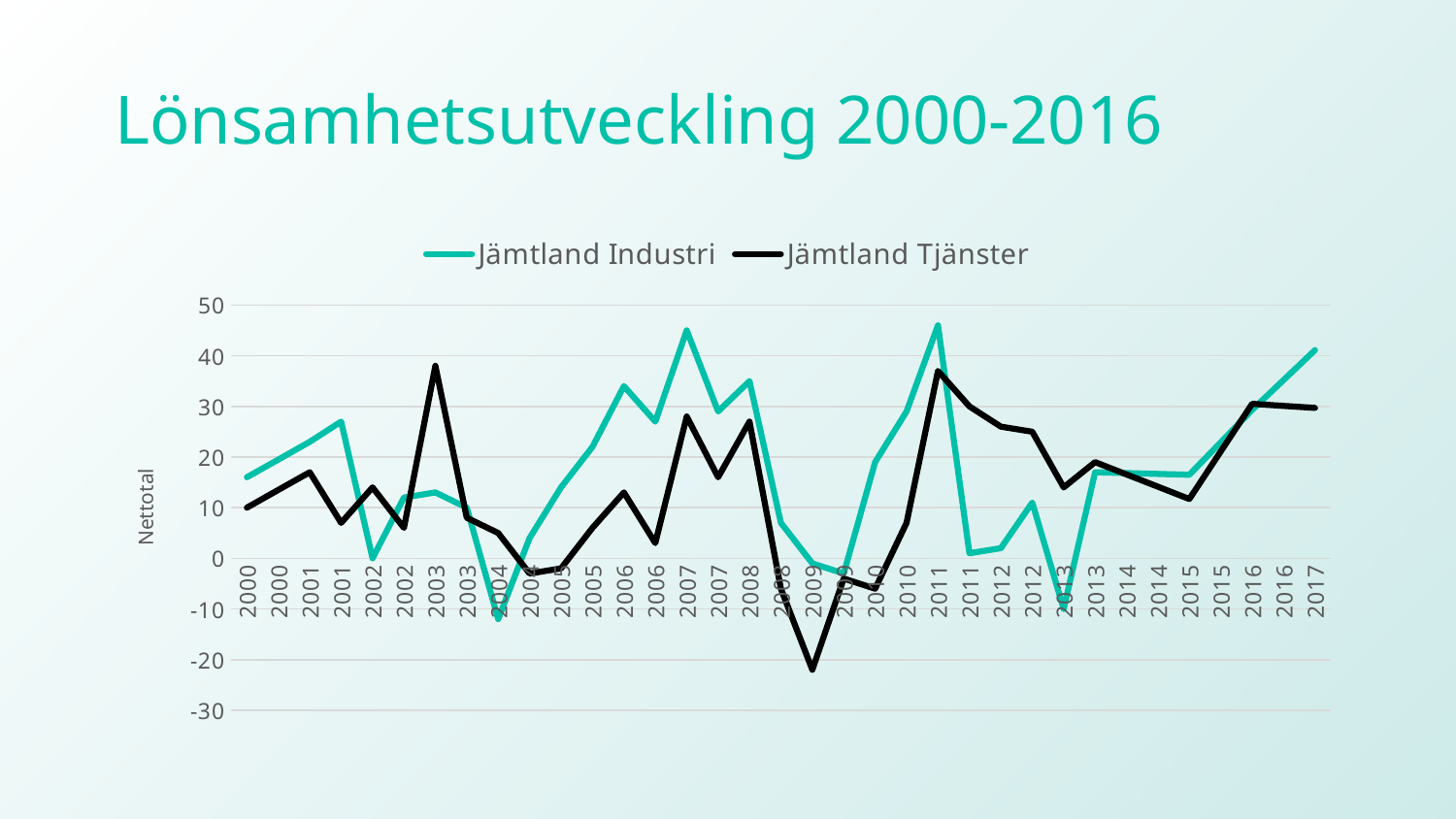
Which series reaches the highest value anywhere on the chart? Jämtland Industri How many series does the legend list? 2 Is the peak value of Jämtland Industri in 2011 greater or less than 40? greater Does the Jämtland Industri line rise or fall from the second 2013 point to 2017? rise Is the lowest value of Jämtland Tjänster (in 2009) greater or less than -10? less Is the value of Jämtland Industri at the first 2013 point greater or less than 0? less What kind of chart is shown on the slide? line chart Which series reaches the lowest value anywhere on the chart? Jämtland Tjänster What is the title of the slide's chart? Lönsamhetsutveckling 2000-2016 At the first 2003 point, which series has the larger value, Jämtland Industri or Jämtland Tjänster? Jämtland Tjänster What is the label on the vertical axis? Nettotal